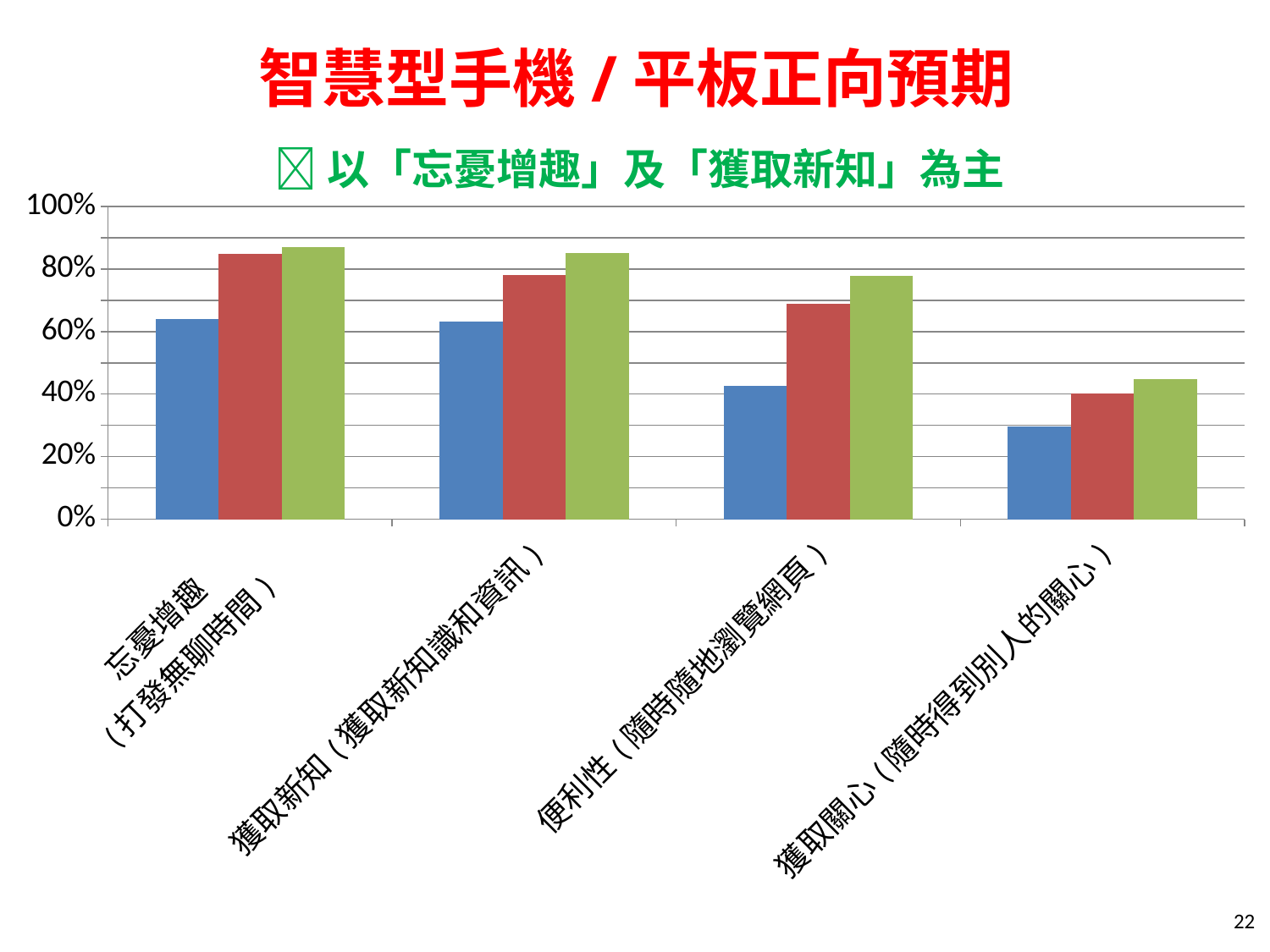
Which colour bar is the tallest within every category? green How many bars are shown for each category in the chart? 3 Is the green bar for 獲取關心（隨時得到別人的關心） greater or less than 40%? greater Which category has the lowest values across all three bars? 獲取關心（隨時得到別人的關心） Is the blue bar for 忘憂增趣（打發無聊時間） greater or less than 60%? greater Which is larger: the blue bar for 忘憂增趣（打發無聊時間） or the blue bar for 便利性（隨時隨地瀏覽網頁）? 忘憂增趣（打發無聊時間） Is the blue bar for 獲取關心（隨時得到別人的關心） greater or less than 40%? less How many categories are shown on the x axis of the chart? 4 What kind of chart is shown on the slide? bar chart Do the green bars rise or fall from left to right across the categories? fall Which category has the tallest red bar? 忘憂增趣（打發無聊時間）